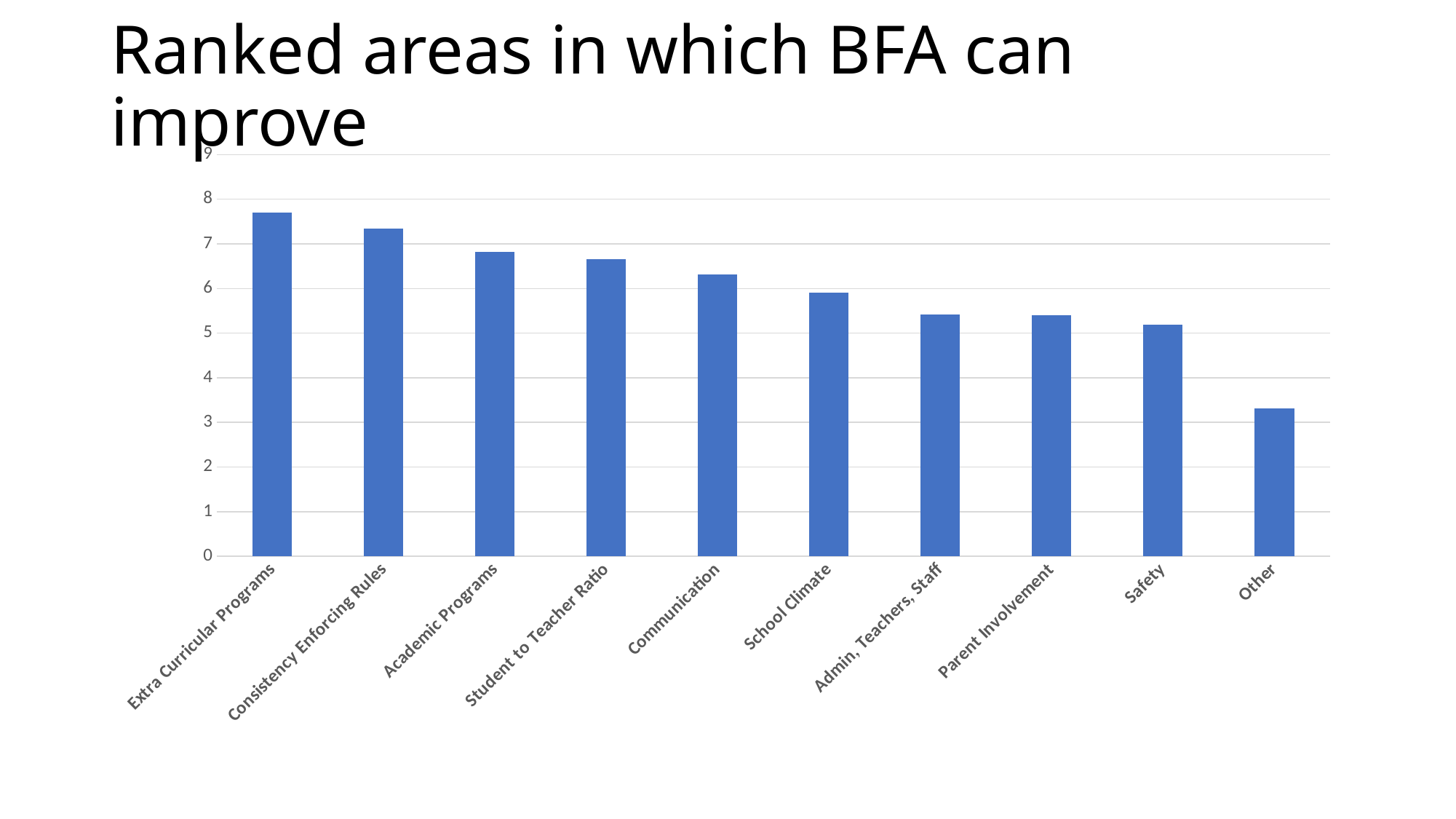
Is the value for Safety greater or less than 6? less Is the value for Other greater or less than 4? less How many categories are plotted in the chart? 10 Which is larger, the value for Safety or the value for Other? Safety Which category has the lowest bar? Other Which category has the highest bar? Extra Curricular Programs What is the title of the slide containing the chart? Ranked areas in which BFA can improve Is the value for Communication greater or less than 6? greater Which is larger, the value for Academic Programs or the value for School Climate? Academic Programs Do the values rise or fall moving from left to right along the x axis? fall What kind of chart is shown on the slide? bar chart